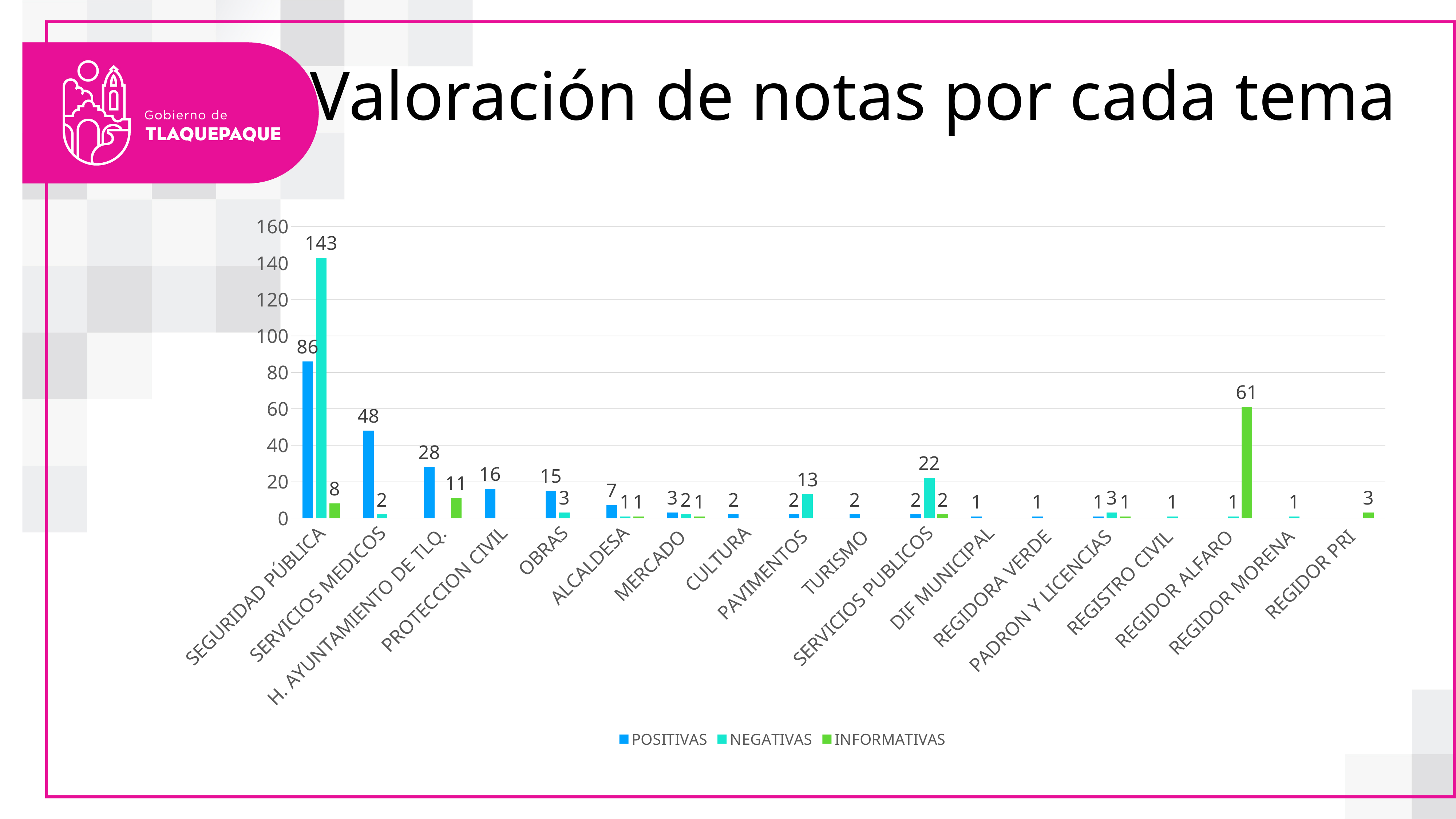
What is the INFORMATIVAS value for REGIDOR ALFARO? 61 Which is larger for PAVIMENTOS, the POSITIVAS value or the NEGATIVAS value? NEGATIVAS How many series does the legend list? 3 What is the NEGATIVAS value for SEGURIDAD PÚBLICA? 143 How many categories are shown on the x axis? 18 Is the NEGATIVAS value for SEGURIDAD PÚBLICA greater or less than 140? greater What kind of chart is shown on the slide? Bar chart What is the NEGATIVAS value for SERVICIOS PUBLICOS? 22 What is the difference between the NEGATIVAS and POSITIVAS values for SEGURIDAD PÚBLICA? 57 What is the total of the three values for SERVICIOS PUBLICOS? 26 What is the POSITIVAS value for SERVICIOS MEDICOS? 48 Which category has the highest POSITIVAS value? SEGURIDAD PÚBLICA